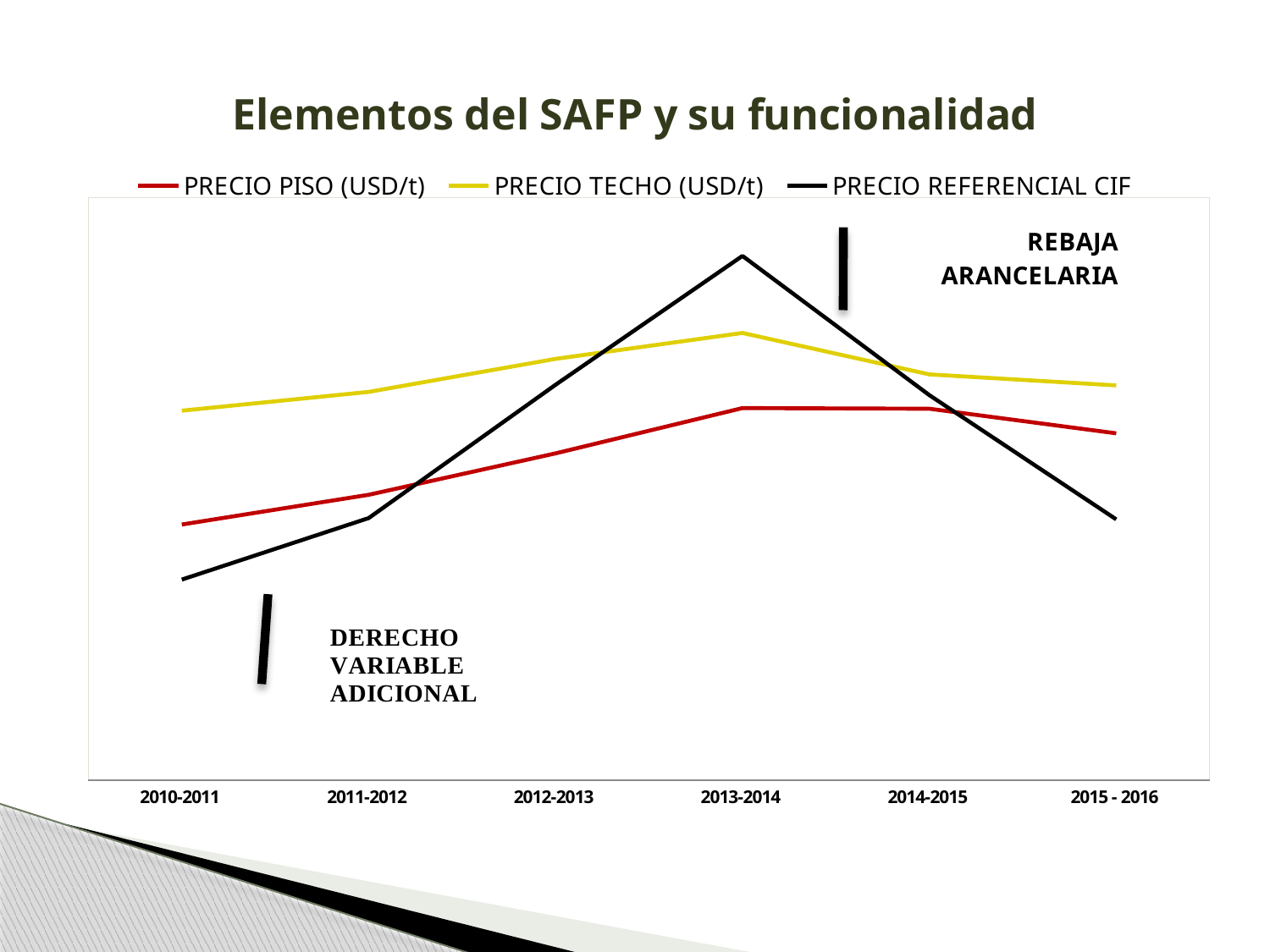
What colour is the line for PRECIO PISO (USD/t)? red Does PRECIO REFERENCIAL CIF rise or fall from 2013-2014 to 2015 - 2016? fall Does PRECIO TECHO (USD/t) rise or fall from 2010-2011 to 2013-2014? rise In 2013-2014, which is higher: PRECIO REFERENCIAL CIF or PRECIO TECHO (USD/t)? PRECIO REFERENCIAL CIF In 2010-2011, which is higher: PRECIO PISO (USD/t) or PRECIO REFERENCIAL CIF? PRECIO PISO (USD/t) How many periods are shown on the x axis? 6 What kind of chart is shown on the slide? line chart In which period is PRECIO REFERENCIAL CIF at its lowest value? 2010-2011 In 2015 - 2016, which is higher: PRECIO PISO (USD/t) or PRECIO REFERENCIAL CIF? PRECIO PISO (USD/t) How many series does the legend list? 3 In which period does PRECIO REFERENCIAL CIF reach its highest value? 2013-2014 In which period does PRECIO TECHO (USD/t) reach its highest value? 2013-2014